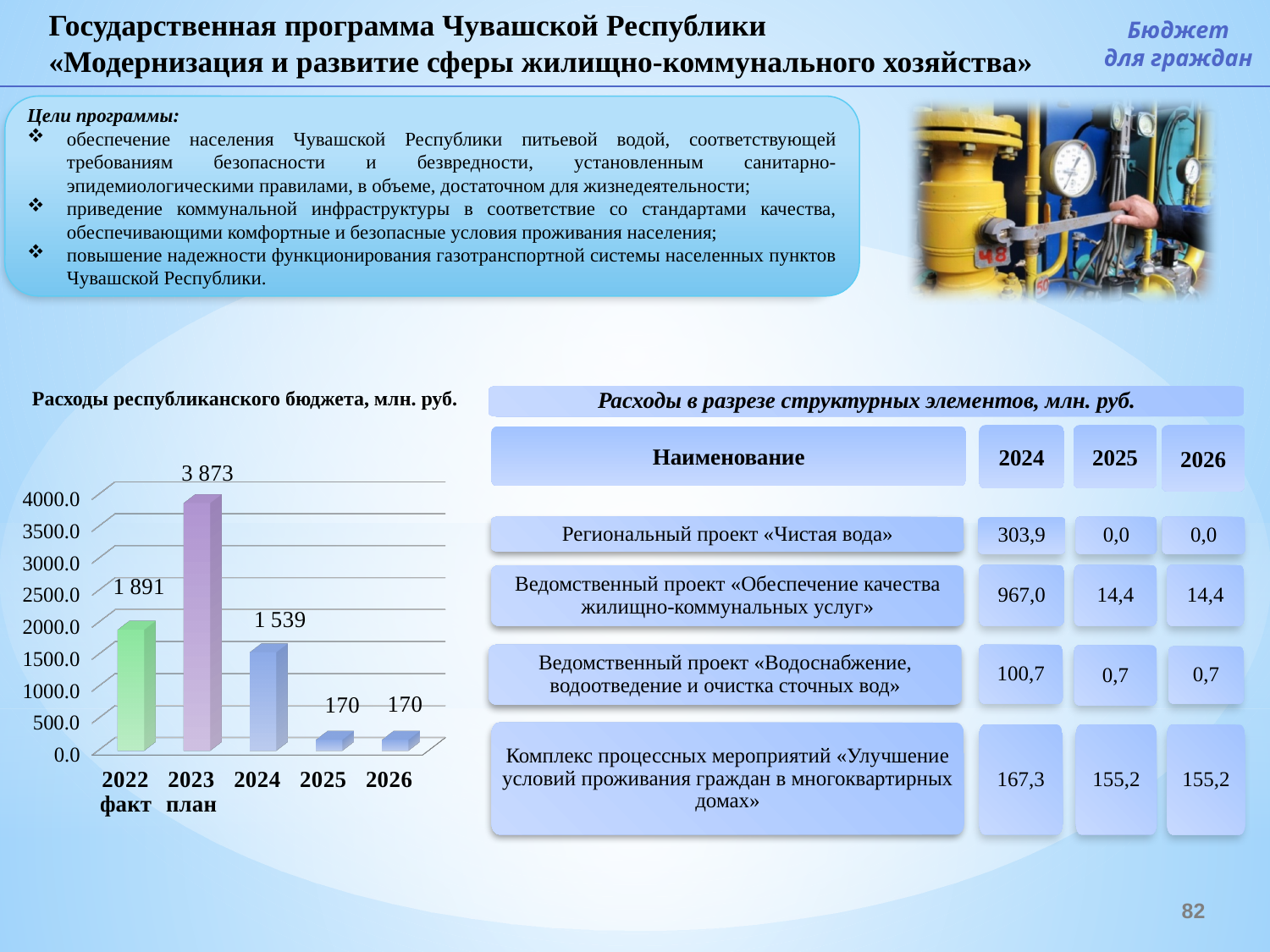
How many years are shown on the x axis of the chart 'Расходы республиканского бюджета, млн. руб.'? 5 What is the value for 2023 in the chart 'Расходы республиканского бюджета, млн. руб.'? 3 873 In the chart 'Расходы республиканского бюджета, млн. руб.', do the values rise or fall from 2023 to 2025? fall What is the value for 2026 in the chart 'Расходы республиканского бюджета, млн. руб.'? 170 What is the value for 2022 in the chart 'Расходы республиканского бюджета, млн. руб.'? 1 891 What is the difference between the 2022 and 2024 values in the chart 'Расходы республиканского бюджета, млн. руб.'? 352 Which year has the highest value in the chart 'Расходы республиканского бюджета, млн. руб.'? 2023 Is the value for 2024 in the chart 'Расходы республиканского бюджета, млн. руб.' greater or less than 2000.0? less What is the difference between the 2023 and 2022 values in the chart 'Расходы республиканского бюджета, млн. руб.'? 1 982 What kind of chart is 'Расходы республиканского бюджета, млн. руб.'? bar chart What is the value for 2024 in the chart 'Расходы республиканского бюджета, млн. руб.'? 1 539 Which is larger in the chart 'Расходы республиканского бюджета, млн. руб.': the value for 2022 or the value for 2024? 2022